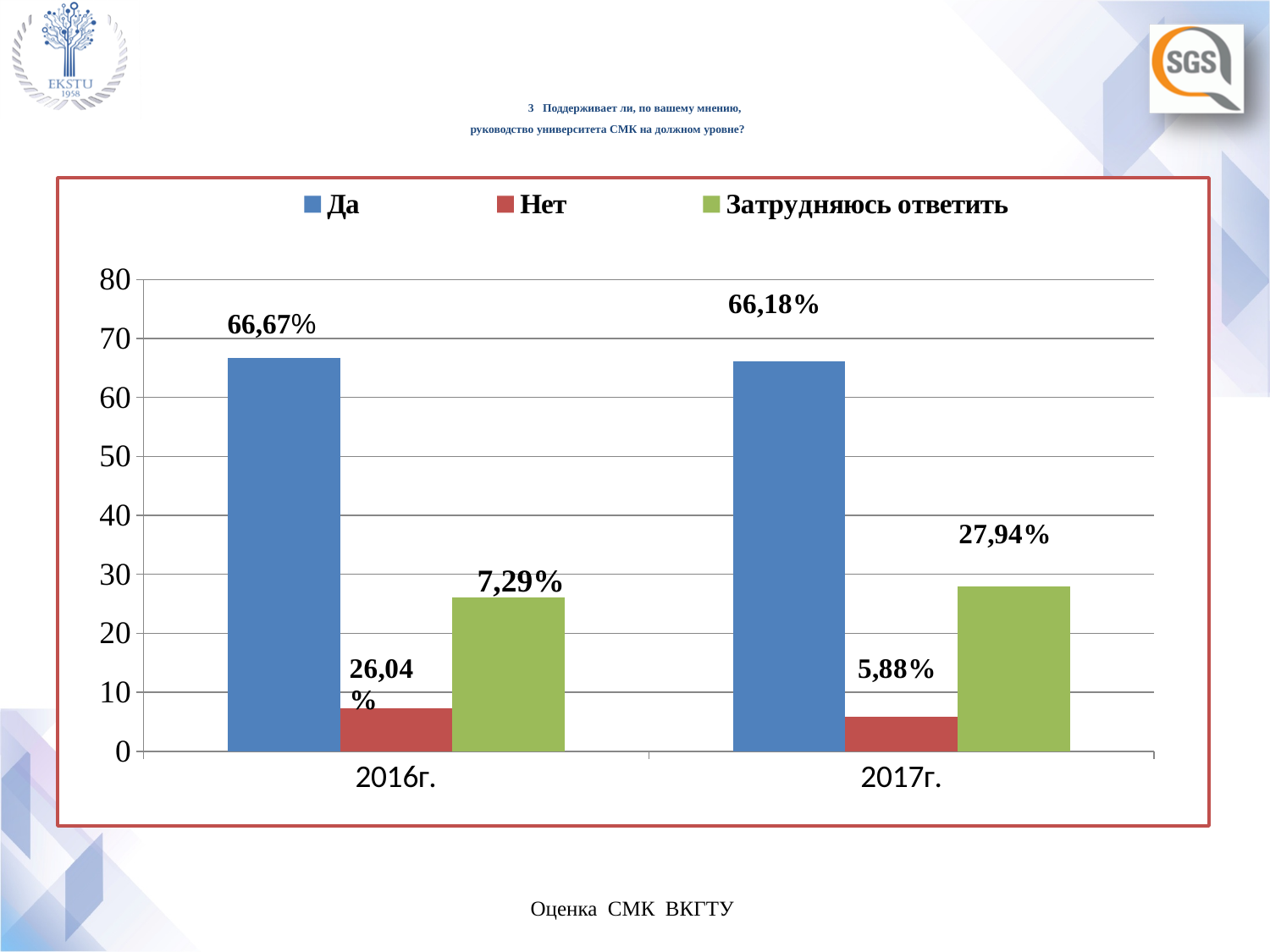
What kind of chart is shown on the slide? bar chart Which answer option has the lowest value in 2017г.? Нет What is the value for Да in 2016г.? 66,67% What is the difference between the Да values for 2016г. and 2017г.? 0,49% Which year has the larger value for Да, 2016г. or 2017г.? 2016г. Which answer option has the highest value in 2017г.? Да What is the value for Да in 2017г.? 66,18% What is the value for Затрудняюсь ответить in 2017г.? 27,94% How many series does the legend list? 3 Is the value for Да in 2017г. greater or less than 60? greater What is the difference between Затрудняюсь ответить and Нет in 2017г.? 22,06% What is the value for Нет in 2017г.? 5,88%